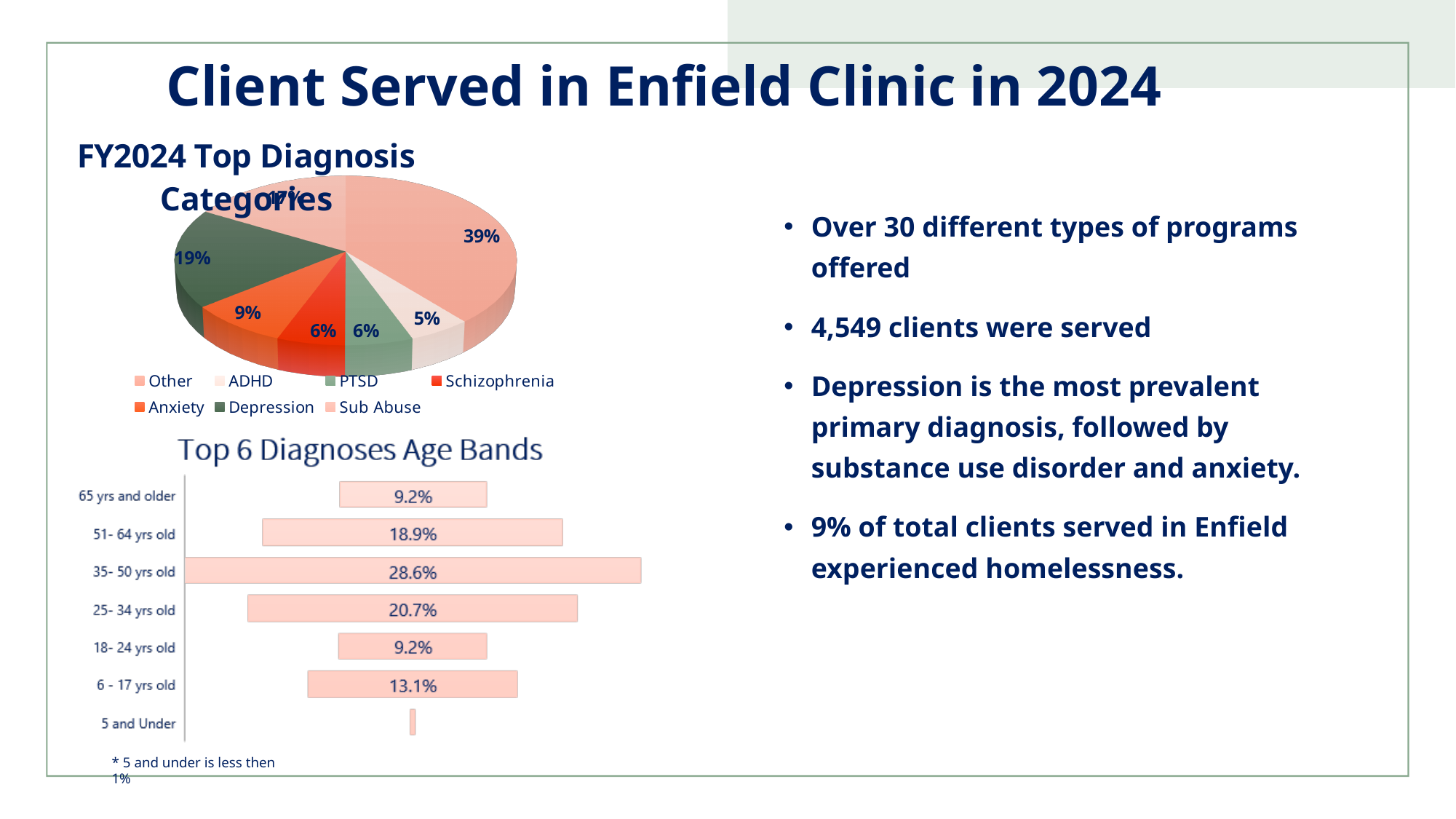
What kind of chart is the Top 6 Diagnoses Age Bands chart? Bar chart How many age bands are shown in the Top 6 Diagnoses Age Bands chart? 7 In the FY2024 Top Diagnosis Categories pie chart, what share does Anxiety have? 9% In the Top 6 Diagnoses Age Bands chart, what is the difference between the values for 35- 50 yrs old and 51- 64 yrs old? 9.7% In the Top 6 Diagnoses Age Bands chart, what is the value for 6 - 17 yrs old? 13.1% In the FY2024 Top Diagnosis Categories pie chart, which category has the largest slice? Other In the FY2024 Top Diagnosis Categories pie chart, what share does Depression have? 19% In the Top 6 Diagnoses Age Bands chart, which age band has the lowest value? 5 and Under In the Top 6 Diagnoses Age Bands chart, what is the value for 35- 50 yrs old? 28.6% How many categories does the legend of the FY2024 Top Diagnosis Categories pie chart list? 7 In the Top 6 Diagnoses Age Bands chart, which age band has the highest value? 35- 50 yrs old In the Top 6 Diagnoses Age Bands chart, which is larger: 51- 64 yrs old or 25- 34 yrs old? 25- 34 yrs old